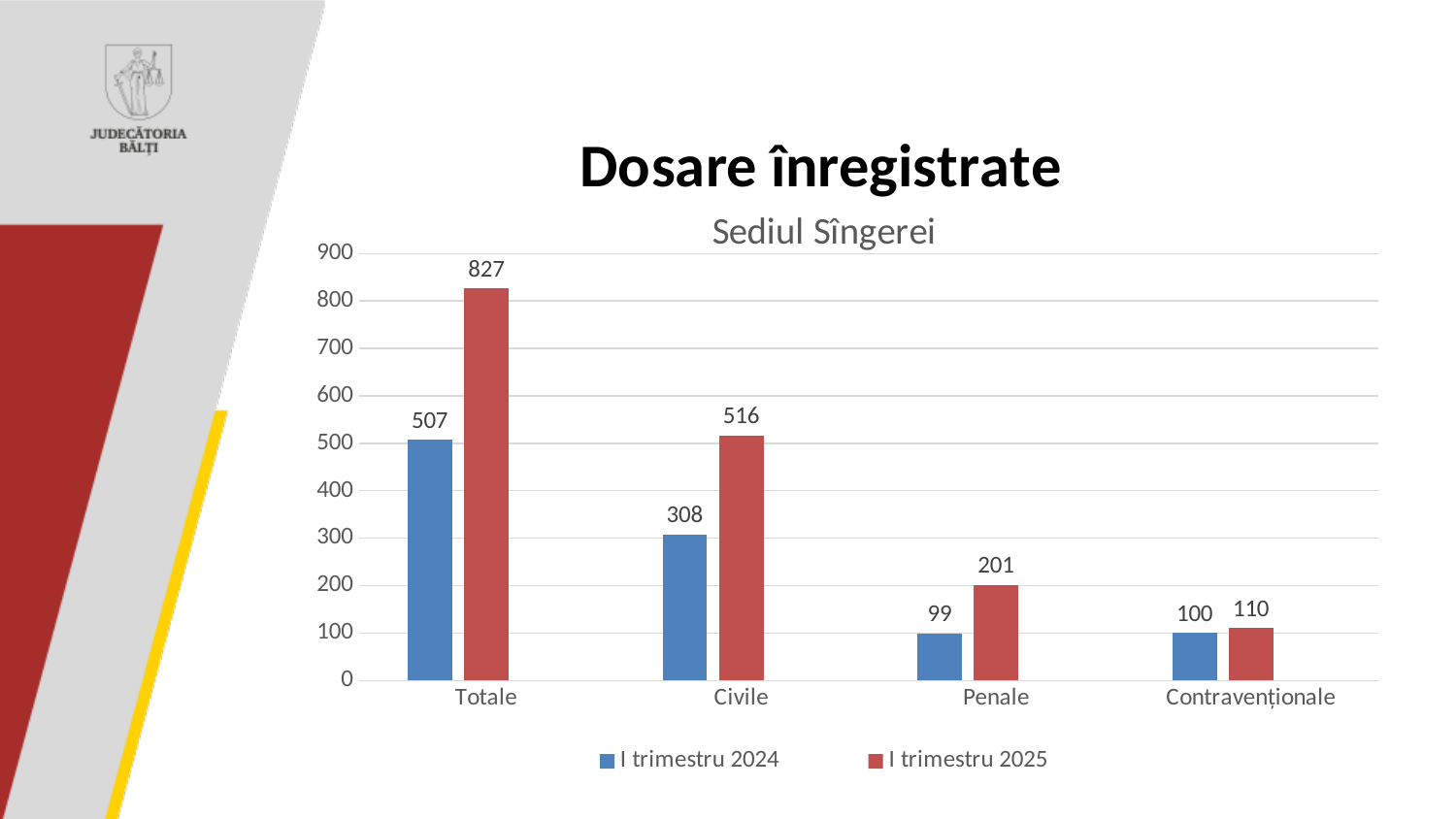
How many categories are shown on the x axis? 4 What kind of chart is shown on the slide? Bar chart What is the value for Civile in I trimestru 2025? 516 Which is larger for Civile: I trimestru 2024 or I trimestru 2025? I trimestru 2025 How many series does the legend list? 2 What is the difference between the I trimestru 2025 and I trimestru 2024 values for Totale? 320 What is the difference between the I trimestru 2025 and I trimestru 2024 values for Penale? 102 What is the value for Penale in I trimestru 2024? 99 What is the subtitle shown above the chart? Sediul Sîngerei Which category has the lowest value in I trimestru 2024? Penale What is the value for Contravenționale in I trimestru 2025? 110 Which category has the highest value in I trimestru 2025? Totale